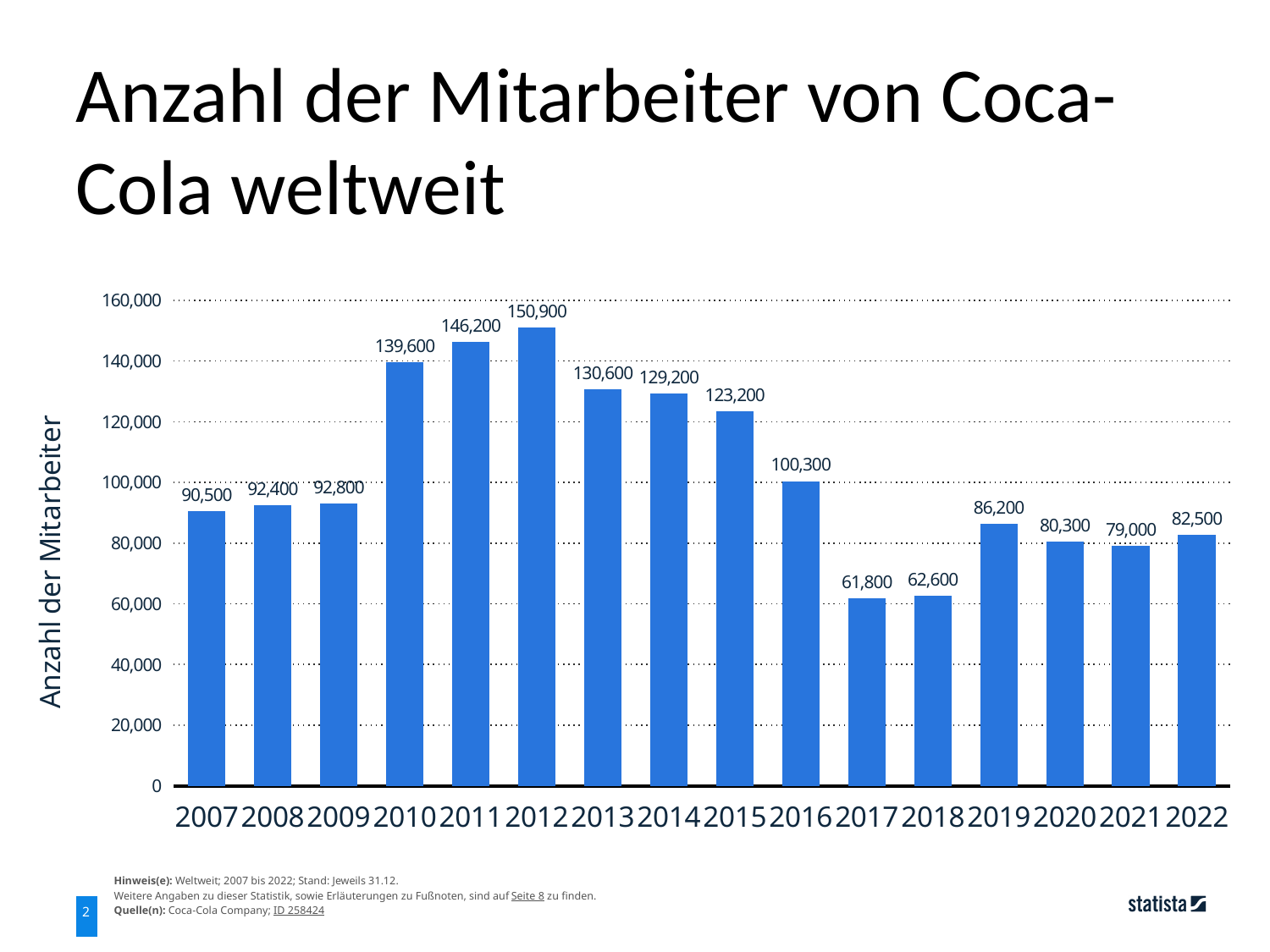
Which year had the highest number of employees? 2012 Did the number of employees rise or fall from 2012 to 2017? Fall Which year had the lowest number of employees? 2017 Which year had more employees, 2010 or 2013? 2010 What was the number of Coca-Cola employees worldwide in 2012? 150,900 What kind of chart is shown on the slide? Bar chart By how much did the number of employees change from 2016 to 2017? 38,500 What was the number of Coca-Cola employees worldwide in 2017? 61,800 What is the difference in the number of employees between 2012 and 2017? 89,100 What was the number of Coca-Cola employees worldwide in 2022? 82,500 Is the value for 2016 greater or less than 80,000? greater How many years are shown on the x axis? 16